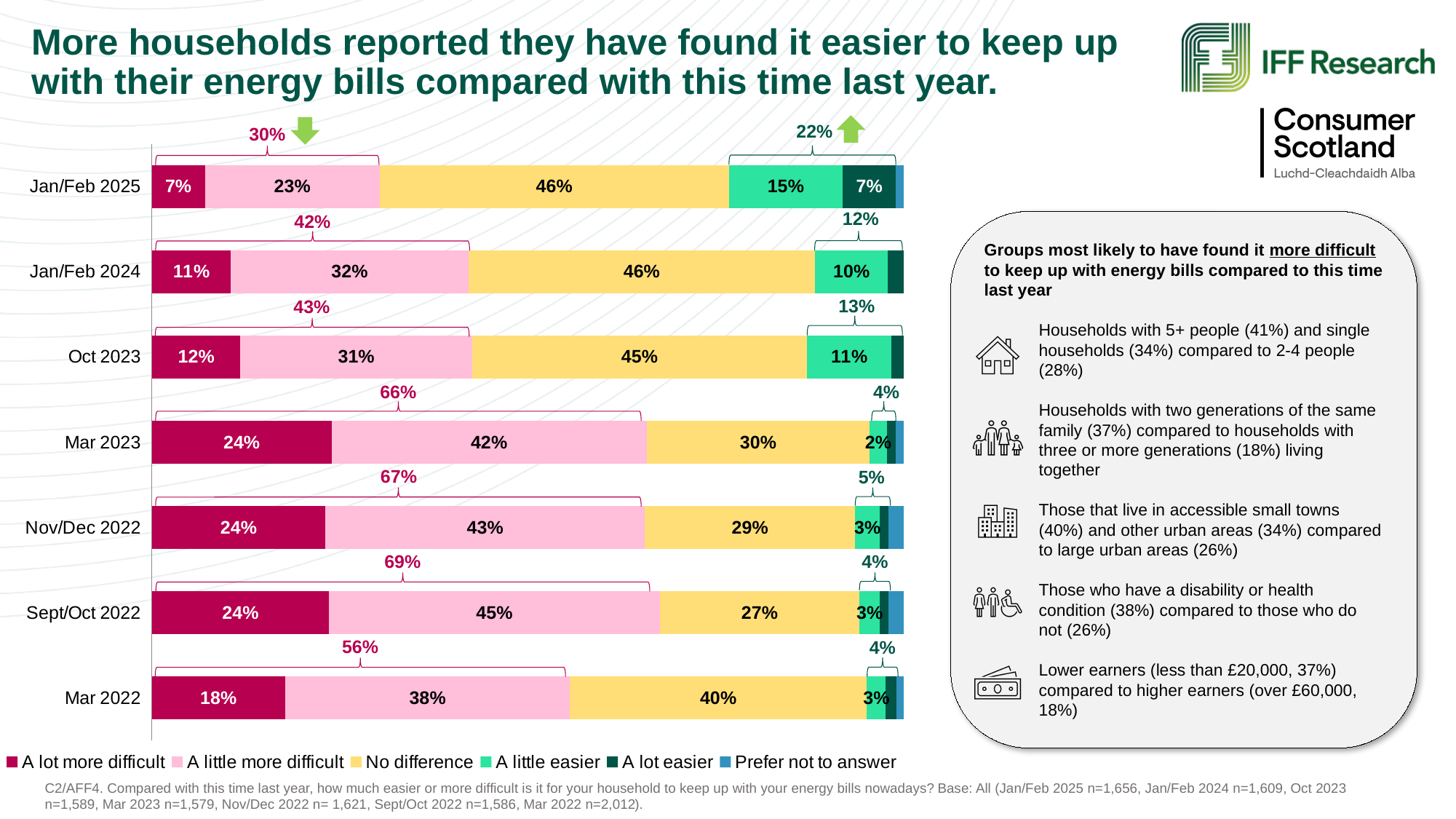
What is the combined 'more difficult' percentage shown above the Jan/Feb 2025 bar? 30% What is the 'A little easier' value for Oct 2023? 11% How many survey periods are shown in the chart? 7 What percentage of households reported 'No difference' in Jan/Feb 2025? 46% Which survey period has the highest 'A little easier' value? Jan/Feb 2025 What percentage of households said it was 'A lot more difficult' in Mar 2022? 18% By how many percentage points did the 'A little more difficult' value fall from Jan/Feb 2024 to Jan/Feb 2025? 9 percentage points Which survey period has the lowest 'A lot more difficult' value? Jan/Feb 2025 What type of chart is shown on the slide? Stacked bar chart How many response categories does the legend list? 6 Which period has the larger 'No difference' value, Mar 2022 or Mar 2023? Mar 2022 Which survey period has the highest 'A little more difficult' value? Sept/Oct 2022